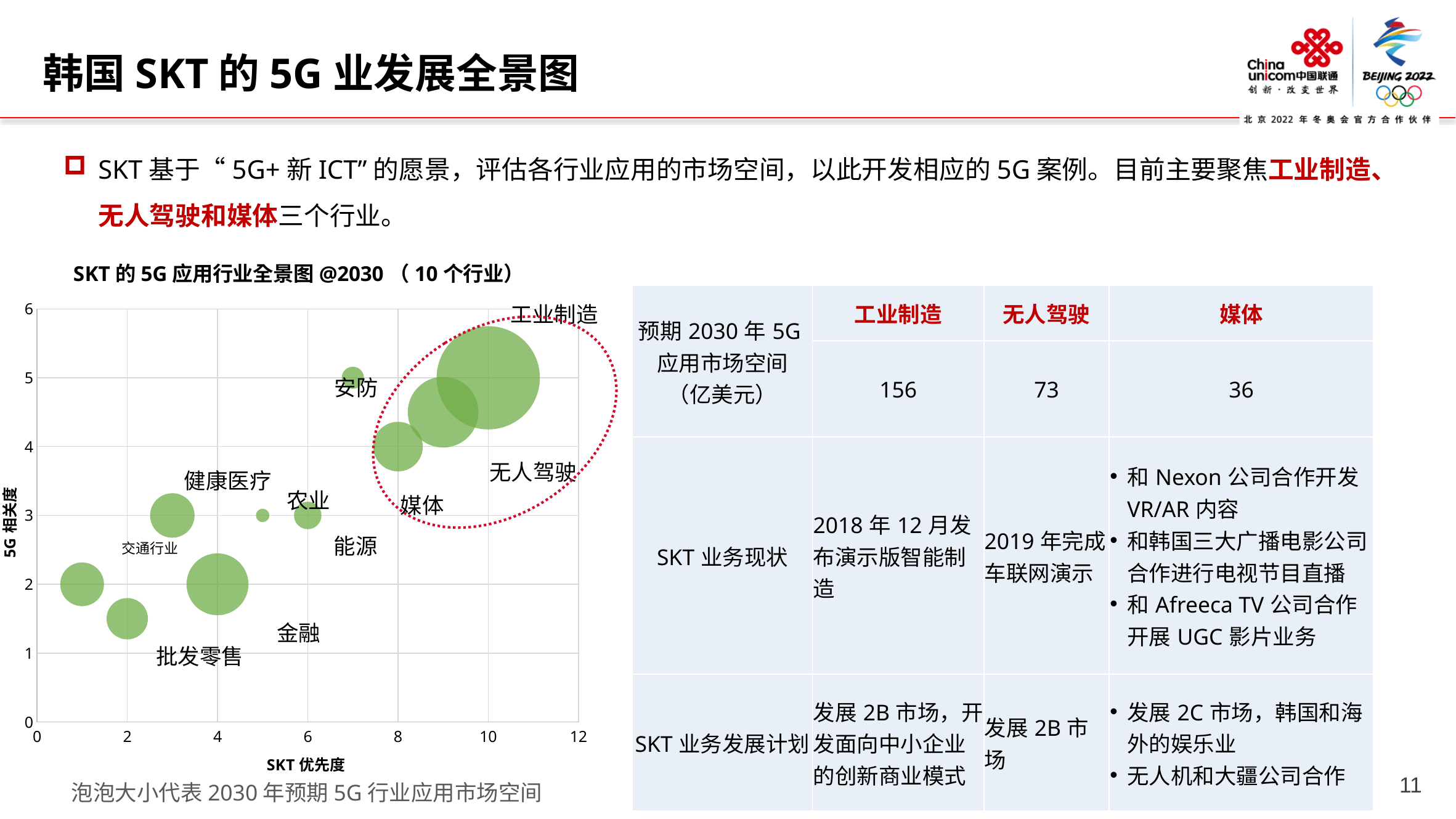
Which industry has the highest SKT 优先度 (x-axis) in the bubble chart? 工业制造 According to the note below the chart, what does the bubble size represent? 2030 年预期 5G 行业应用市场空间 In the bubble chart, what is the SKT 优先度 (x-axis) value for 能源? 6 What kind of chart is shown on the left of the slide? Bubble chart In the bubble chart, what is the SKT 优先度 (x-axis) value for 工业制造? 10 Is the SKT 优先度 value for 无人驾驶 greater or less than 8? greater Which industry has the lowest 5G 相关度 (y-axis) in the bubble chart? 批发零售 How many industries (bubbles) are plotted in the chart 'SKT 的 5G 应用行业全景图 @2030'? 10 In the bubble chart, what is the 5G 相关度 (y-axis) value for 媒体? 4 Which industry has the largest bubble in the chart? 工业制造 In the bubble chart, which has a higher 5G 相关度: 安防 or 健康医疗? 安防 In the bubble chart, what is the 5G 相关度 (y-axis) value for 金融? 2